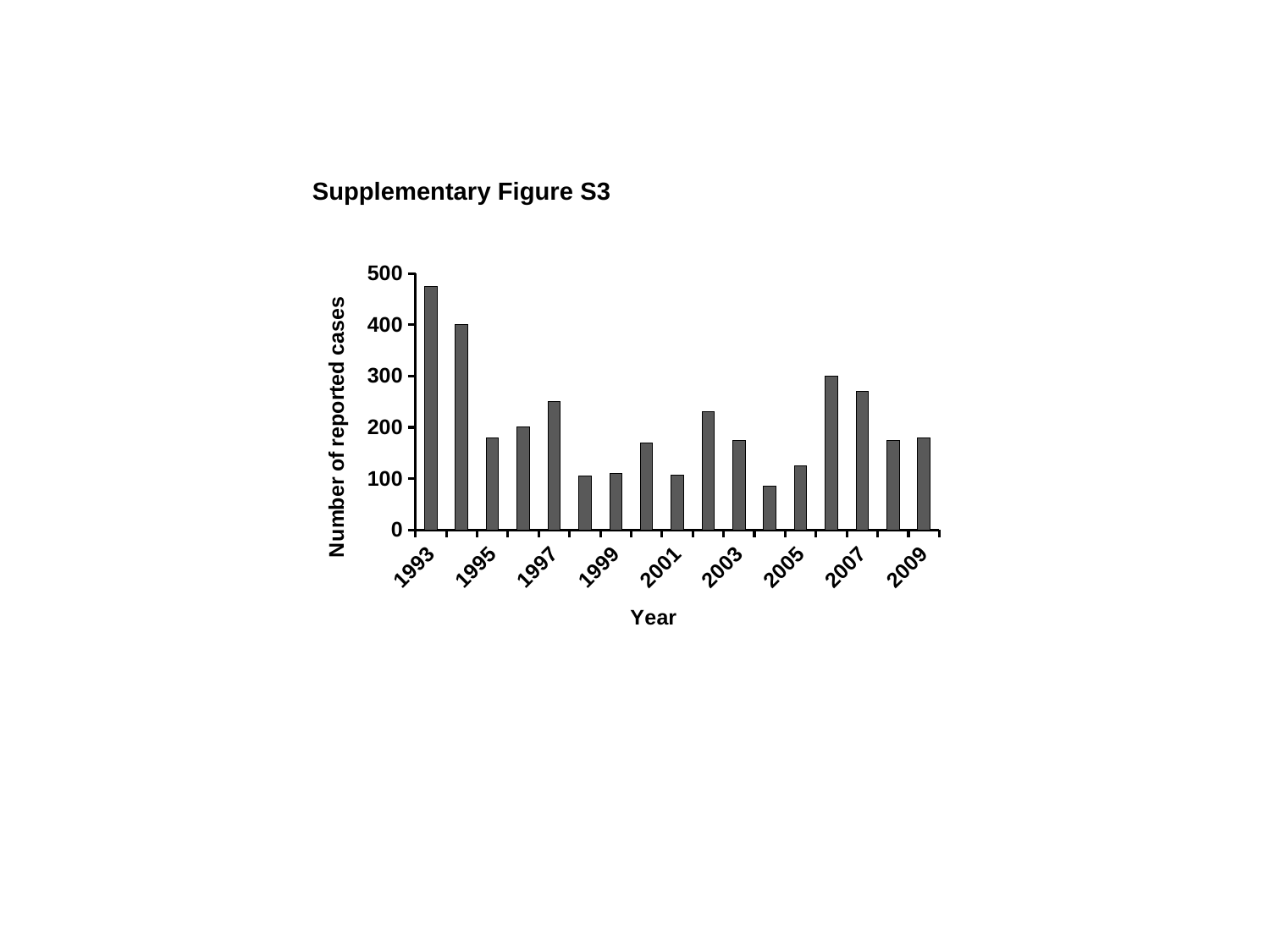
Is the number of reported cases in 1993 greater or less than 400? greater Which year has the lowest number of reported cases? 2004 What kind of chart is shown on the slide? bar chart Is the number of reported cases in 2007 greater or less than 300? less Which year has more reported cases, 1993 or 2006? 1993 Is the number of reported cases in 1997 greater or less than 200? greater Which year has the highest number of reported cases? 1993 What is the label of the vertical axis? Number of reported cases Which year has more reported cases, 2002 or 2005? 2002 How many years (bars) are plotted in the chart? 17 Do the reported cases rise or fall from 1993 to 1995? fall